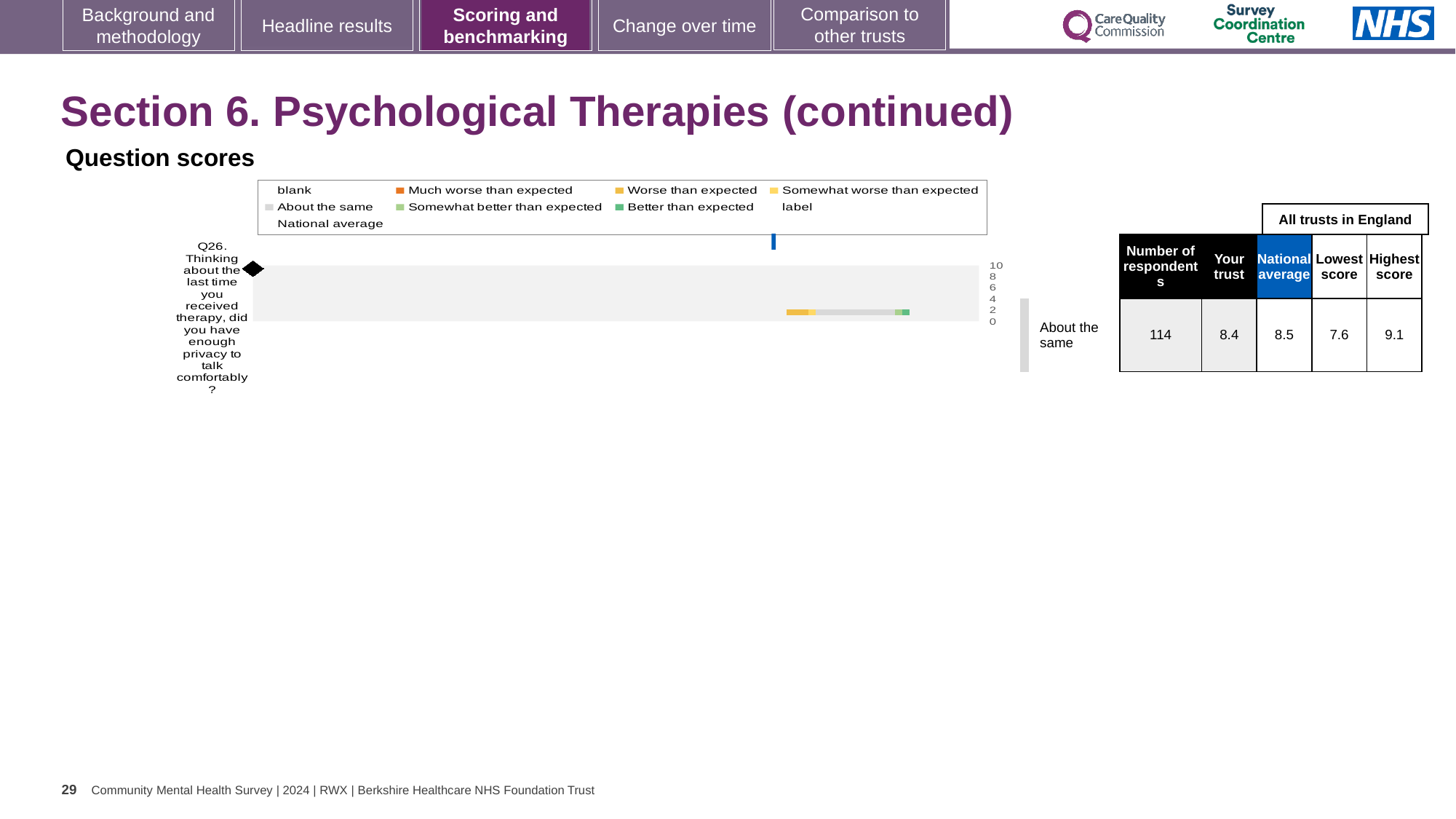
What is the difference between the Highest score and the Lowest score for Q26 in the table beside the chart? 1.5 In the table beside the chart, what is the Lowest score among all trusts in England for Q26? 7.6 What kind of chart is shown under 'Question scores'? bar chart Which question is plotted in the Question scores chart? Q26. Thinking about the last time you received therapy, did you have enough privacy to talk comfortably? In the table beside the chart, what is the National average score for Q26? 8.5 How many respondents answered Q26 according to the table beside the chart? 114 Which is larger for Q26: the 'Your trust' score or the National average? National average What benchmark category is the trust's Q26 score assigned to, as labelled next to the chart? About the same How many questions (categories) are plotted in the Question scores chart? 1 What is the highest tick value shown on the axis of the Question scores chart? 10 In the table beside the chart, what is the 'Your trust' score for Q26? 8.4 In the table beside the chart, what is the Highest score among all trusts in England for Q26? 9.1